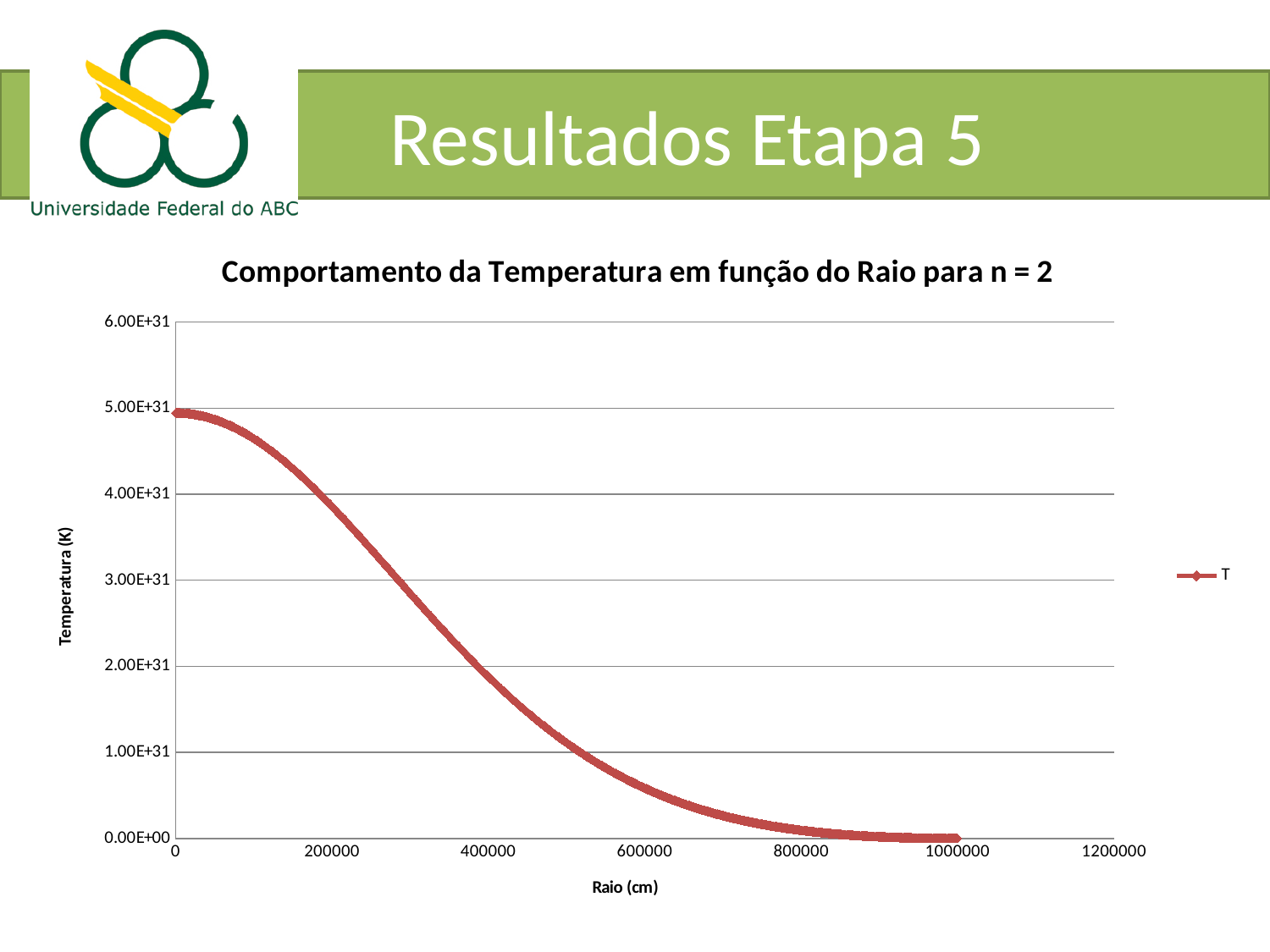
Is the value of T at Raio = 0 greater or less than 4.00E+31? greater Does the temperature rise or fall as the radius increases along the x axis? fall Is the value of T at Raio = 300000 greater or less than 4.00E+31? less How many series does the legend list? 1 Is the value of T at Raio = 800000 greater or less than 1.00E+31? less At which end of the x axis does the series T reach its highest value? Raio = 0 What is the label of the y axis? Temperatura (K) What kind of chart is shown on the slide? line chart Which is larger, the value of T at Raio = 200000 or at Raio = 600000? Raio = 200000 What is the title of the chart? Comportamento da Temperatura em função do Raio para n = 2 What is the name of the series shown in the legend? T